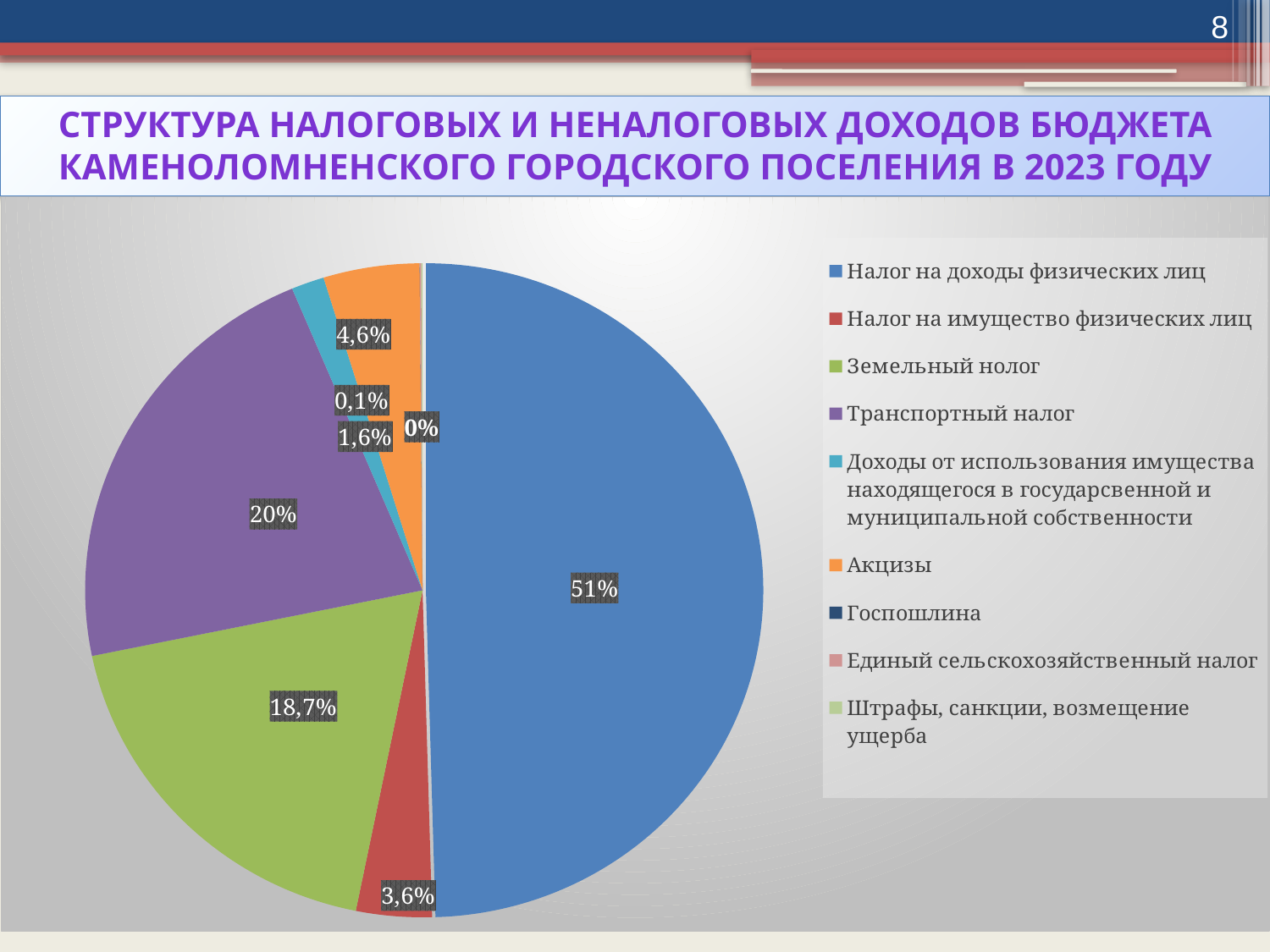
What percentage is shown for Земельный нолог? 18,7% By how many percentage points does Налог на доходы физических лиц exceed Транспортный налог? 31 percentage points What percentage is shown for Доходы от использования имущества находящегося в государсвенной и муниципальной собственности? 1,6% What type of chart is shown on the slide? Pie chart Which category has the largest share of the pie? Налог на доходы физических лиц What share of the pie does Налог на доходы физических лиц account for? 51% What percentage is shown for Налог на имущество физических лиц? 3,6% By how many percentage points does Транспортный налог exceed Земельный нолог? 1,3 percentage points What percentage is shown for Акцизы? 4,6% Which has the larger share: Транспортный налог or Земельный нолог? Транспортный налог How many categories does the legend list? 9 What percentage is shown for Транспортный налог? 20%